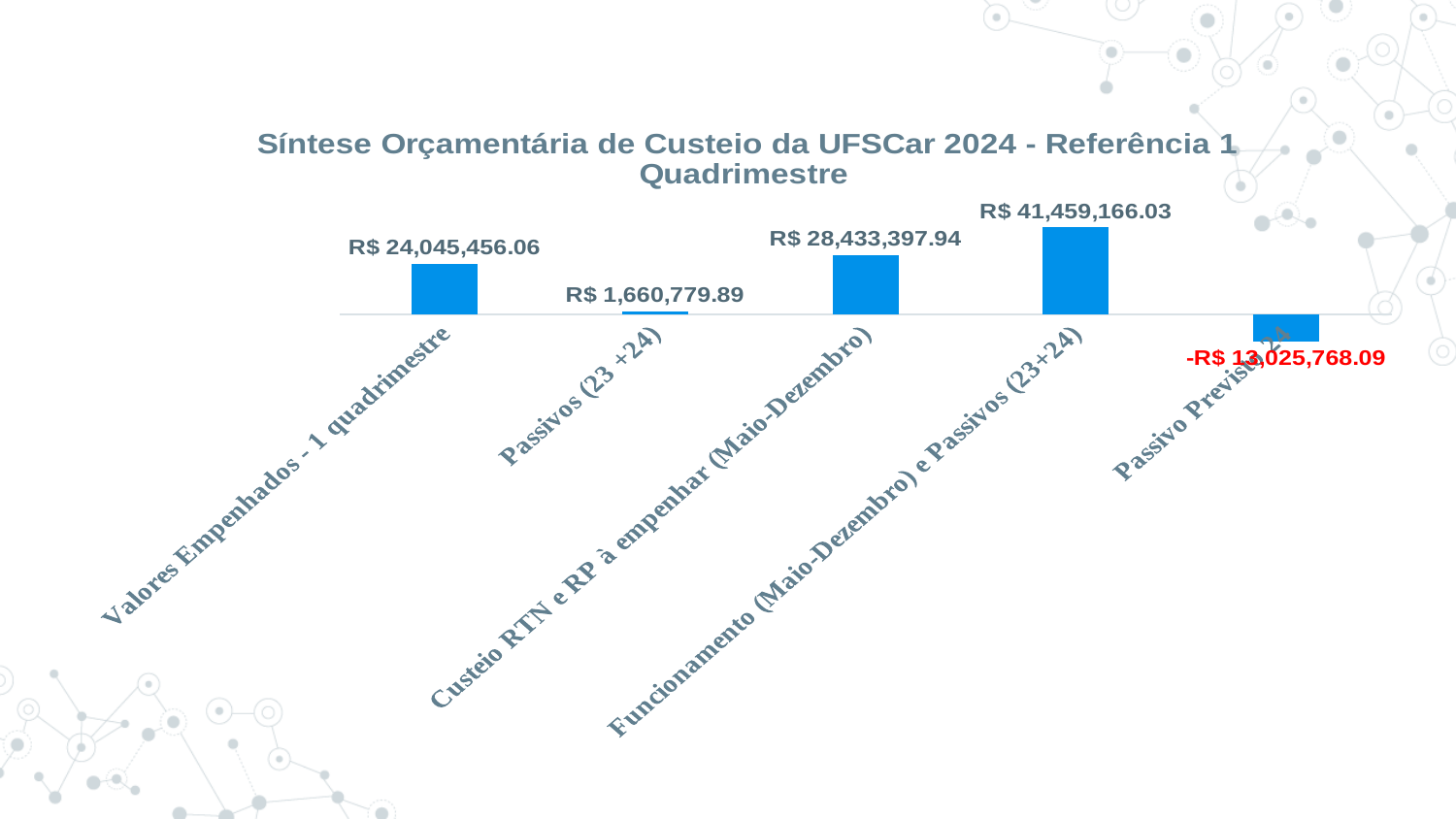
What is the value for "Valores Empenhados - 1 quadrimestre"? R$ 24,045,456.06 What is the value shown for the last (fifth) category, the one with the negative bar? -R$ 13,025,768.09 What is the value for "Passivos (23+24)"? R$ 1,660,779.89 What is the value for "Funcionamento (Maio-Dezembro) e Passivos (23+24)"? R$ 41,459,166.03 What kind of chart is shown on the slide? Bar chart Which of the positive-valued categories has the smallest value? Passivos (23+24) What is the value for "Custeio RTN e RP à empenhar (Maio-Dezembro)"? R$ 28,433,397.94 What is the difference between the values for "Funcionamento (Maio-Dezembro) e Passivos (23+24)" and "Custeio RTN e RP à empenhar (Maio-Dezembro)"? R$ 13,025,768.09 Which is larger: the value for "Valores Empenhados - 1 quadrimestre" or the value for "Custeio RTN e RP à empenhar (Maio-Dezembro)"? Custeio RTN e RP à empenhar (Maio-Dezembro) How many categories are plotted in the chart? 5 What is the title of the chart? Síntese Orçamentária de Custeio da UFSCar 2024 - Referência 1 Quadrimestre Which category has the highest value? Funcionamento (Maio-Dezembro) e Passivos (23+24)